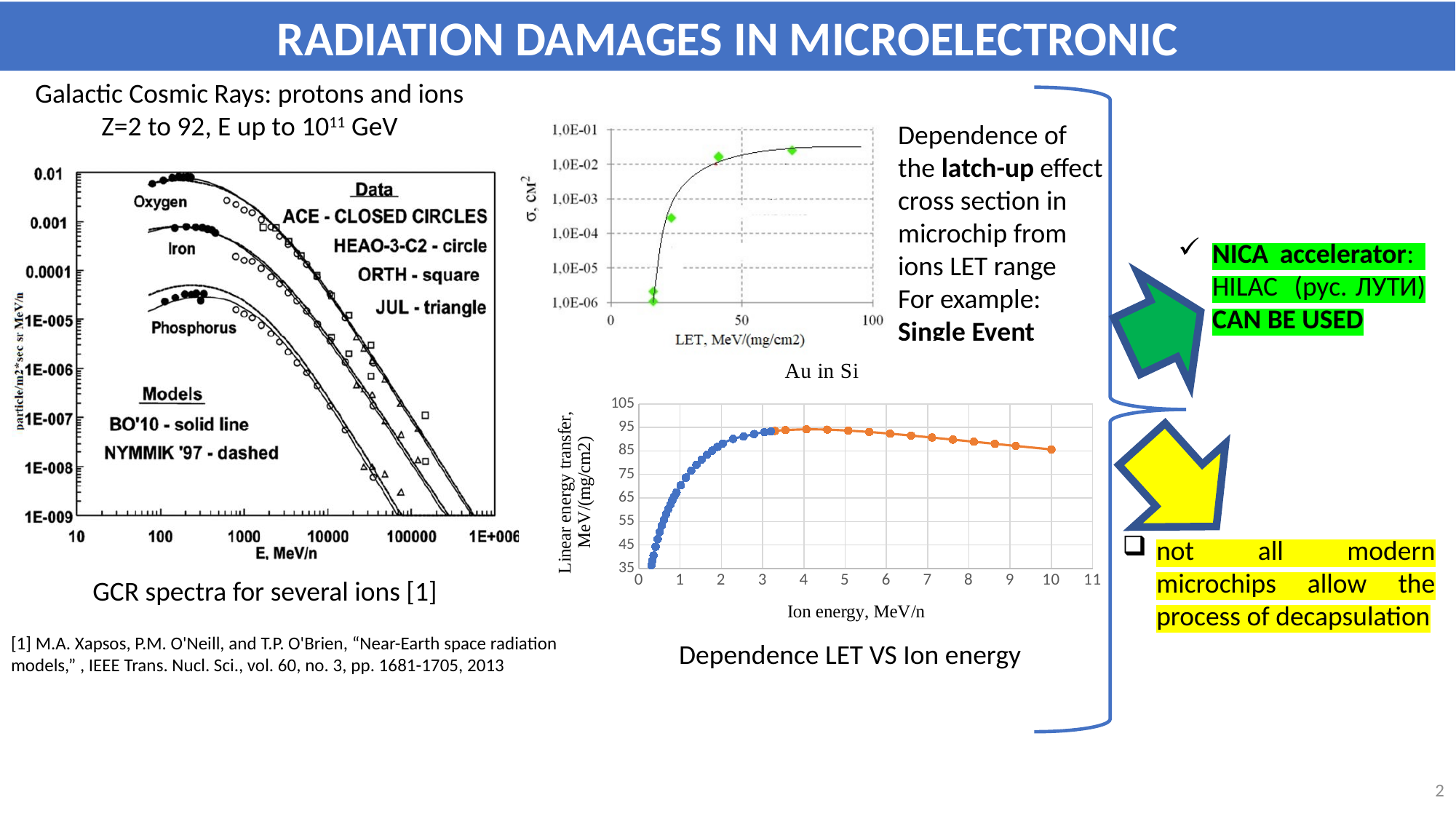
In the 'Dependence LET VS Ion energy' chart, what is the label of the x axis? Ion energy, MeV/n In the 'Dependence LET VS Ion energy' chart, how does the LET change as ion energy increases from 0 to about 4 MeV/n? it rises What kind of chart is the 'Dependence LET VS Ion energy' chart at the bottom middle of the slide? line chart with markers In the 'Dependence LET VS Ion energy' chart, is the lowest plotted value (near 0.3 MeV/n) greater or less than 45? less In the GCR spectra chart on the left, which ion has the lowest particle flux? Phosphorus In the 'Dependence LET VS Ion energy' chart, which is larger: the LET at 4 MeV/n or the LET at 10 MeV/n? the LET at 4 MeV/n In the latch-up cross section chart (top middle, 'Au in Si'), does the cross section rise or fall as LET increases? it rises In the 'Dependence LET VS Ion energy' chart, what is the label of the y axis? Linear energy transfer, MeV/(mg/cm2) In the 'Dependence LET VS Ion energy' chart, how does the LET change as ion energy increases from about 4 to 10 MeV/n? it falls In the GCR spectra chart on the left, which ion has the highest particle flux? Oxygen In the latch-up cross section chart (top middle, 'Au in Si'), what is the label of the x axis? LET, MeV/(mg/cm2) In the 'Dependence LET VS Ion energy' chart, is the value at an ion energy of 10 MeV/n greater or less than 75? greater